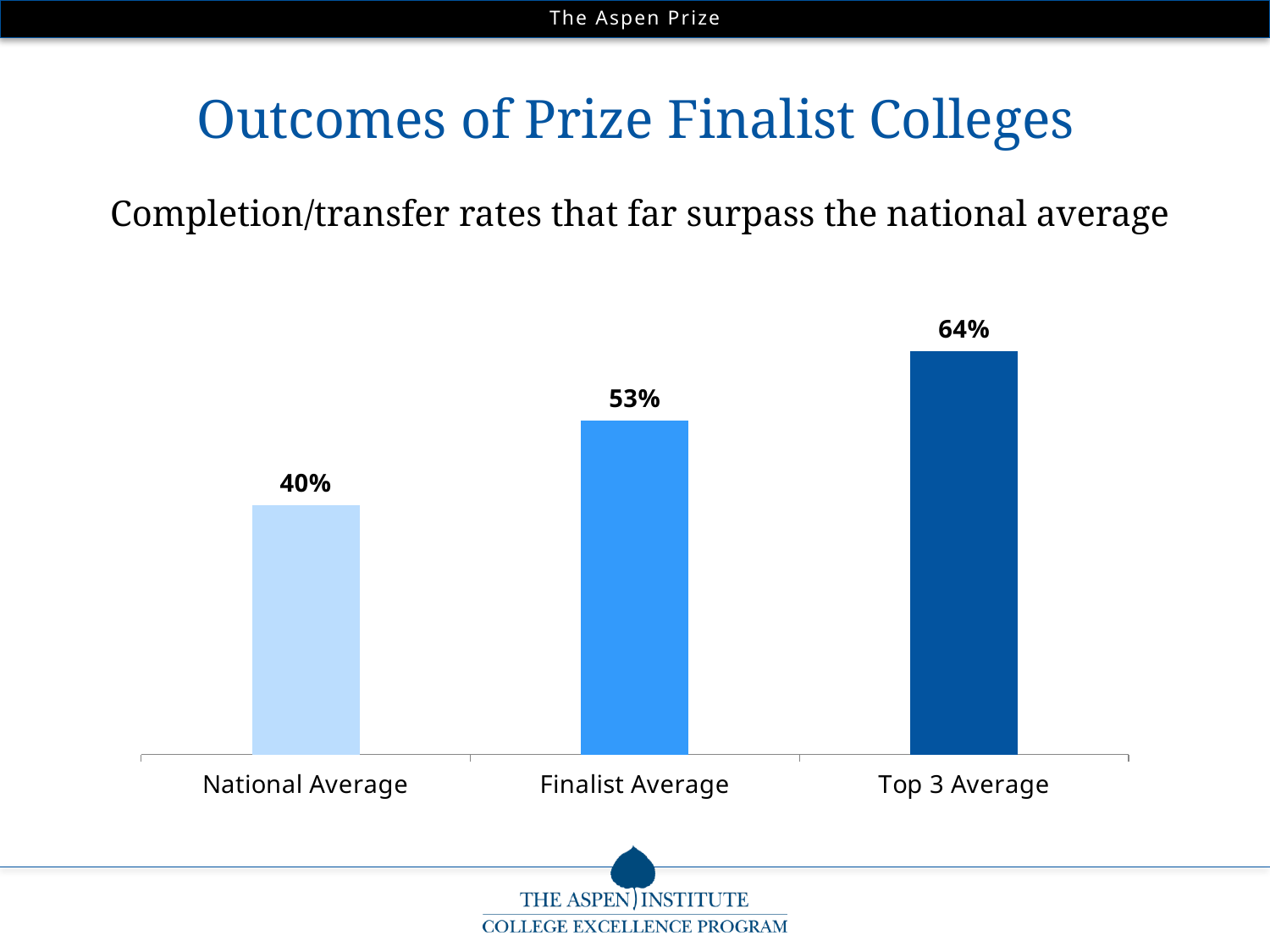
Do the values rise or fall from left to right across the categories? Rise Which category has the lowest value? National Average What is the difference between the Top 3 Average and the National Average? 24% What is the title of the slide containing the chart? Outcomes of Prize Finalist Colleges Which category has the highest value? Top 3 Average Which is larger, the Finalist Average or the Top 3 Average? Top 3 Average What is the difference between the Finalist Average and the National Average? 13% What is the value for National Average? 40% What kind of chart is shown on the slide? Bar chart What is the value for Finalist Average? 53% What is the value for Top 3 Average? 64% How many categories are shown in the chart? 3